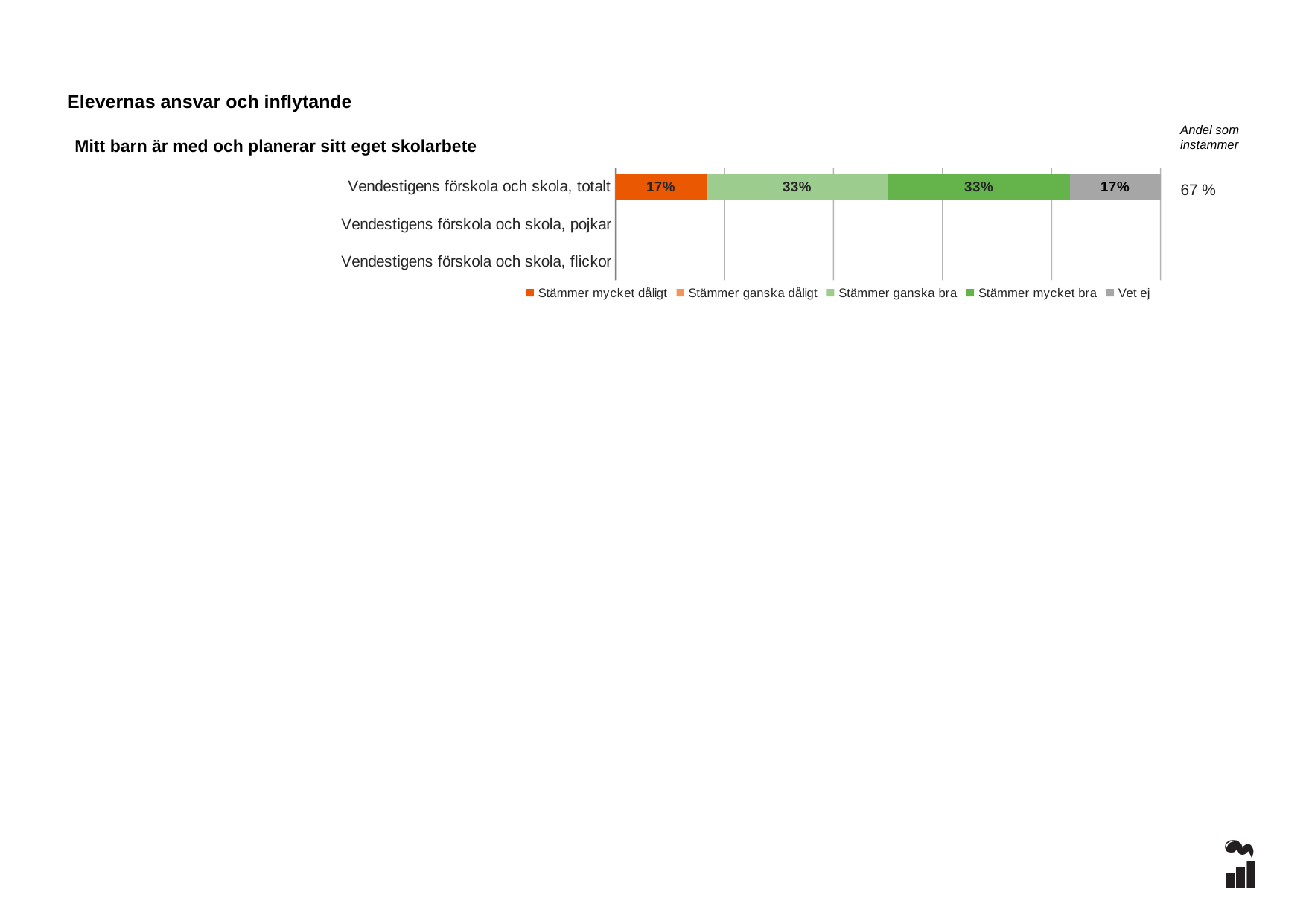
What is the "Andel som instämmer" value shown for Vendestigens förskola och skola, totalt? 67 % How many category rows are shown on the y axis of the chart? 3 What kind of chart is shown on the slide? Stacked bar chart What is the value for "Vet ej" for Vendestigens förskola och skola, totalt? 17% What is the title of the chart? Mitt barn är med och planerar sitt eget skolarbete What is the difference between the "Stämmer ganska bra" and "Vet ej" values for Vendestigens förskola och skola, totalt? 16% What is the value for "Stämmer mycket dåligt" for Vendestigens förskola och skola, totalt? 17% Which is larger for Vendestigens förskola och skola, totalt: "Stämmer mycket bra" or "Stämmer mycket dåligt"? Stämmer mycket bra What is the value for "Stämmer ganska bra" for Vendestigens förskola och skola, totalt? 33% What is the value for "Stämmer mycket bra" for Vendestigens förskola och skola, totalt? 33% Which legend entry is shown in grey? Vet ej How many series does the legend list? 5